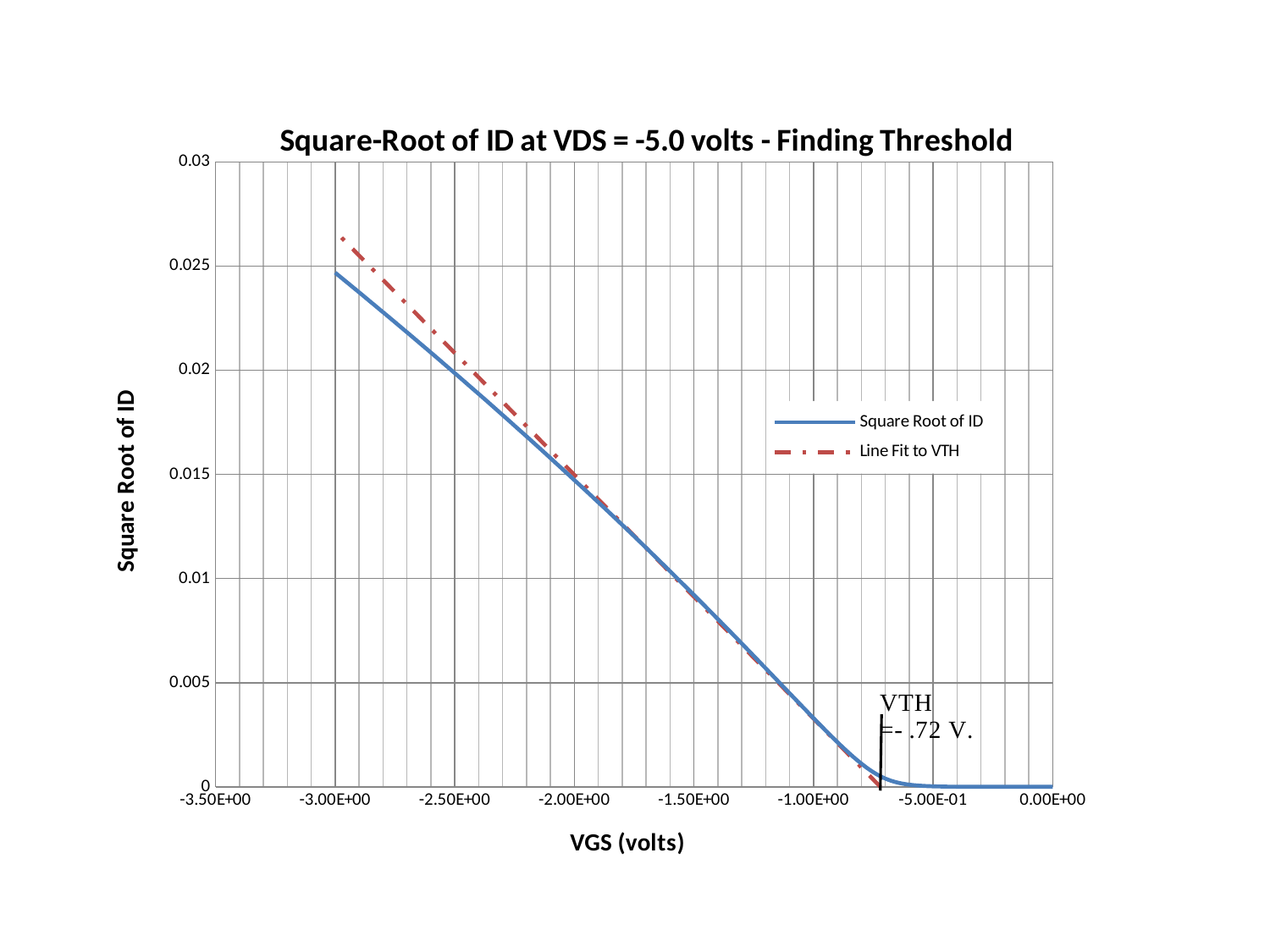
At VGS = -3.00E+00, which series has the larger value, Square Root of ID or Line Fit to VTH? Line Fit to VTH How many series does the legend list? 2 Is the value of the Line Fit to VTH at VGS = -3.00E+00 greater or less than 0.025? greater What is the title of the chart? Square-Root of ID at VDS = -5.0 volts - Finding Threshold What kind of chart is shown on the slide? line chart Is the value of Square Root of ID at VGS = -1.00E+00 greater or less than 0.005? less What are the two series named in the legend? Square Root of ID and Line Fit to VTH What is the label of the x axis? VGS (volts) What threshold voltage (VTH) is annotated on the chart? -.72 V Does the Square Root of ID rise or fall as VGS increases from -3.00E+00 toward 0.00E+00? fall Is the value of Square Root of ID at VGS = -5.00E-01 greater or less than 0.005? less